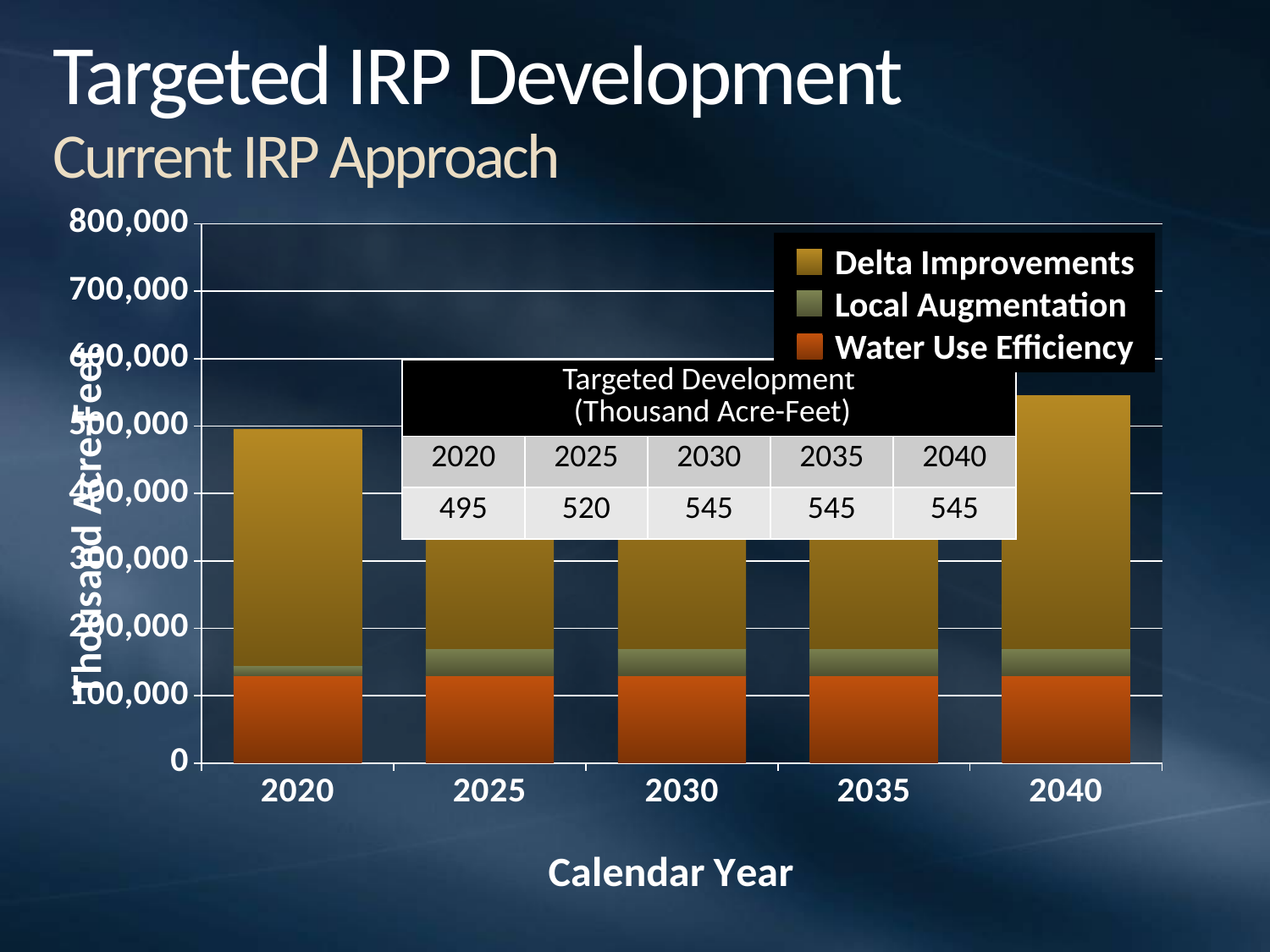
Is the Water Use Efficiency value for 2020 greater or less than 100,000? greater How many calendar years are shown on the x axis? 5 By how much does the targeted development for 2025 exceed that for 2020, in thousand acre-feet? 25 Which is larger, the total targeted development for 2020 or for 2025? 2025 According to the Targeted Development table, what is the value for 2040 in thousand acre-feet? 545 According to the Targeted Development table, what is the value for 2020 in thousand acre-feet? 495 What is the title of the x axis? Calendar Year What is the difference in targeted development between 2030 and 2020, in thousand acre-feet? 50 Which year has the lowest total targeted development? 2020 According to the Targeted Development table, what is the value for 2025 in thousand acre-feet? 520 What kind of chart is shown on the slide? bar chart How many series does the legend list? 3